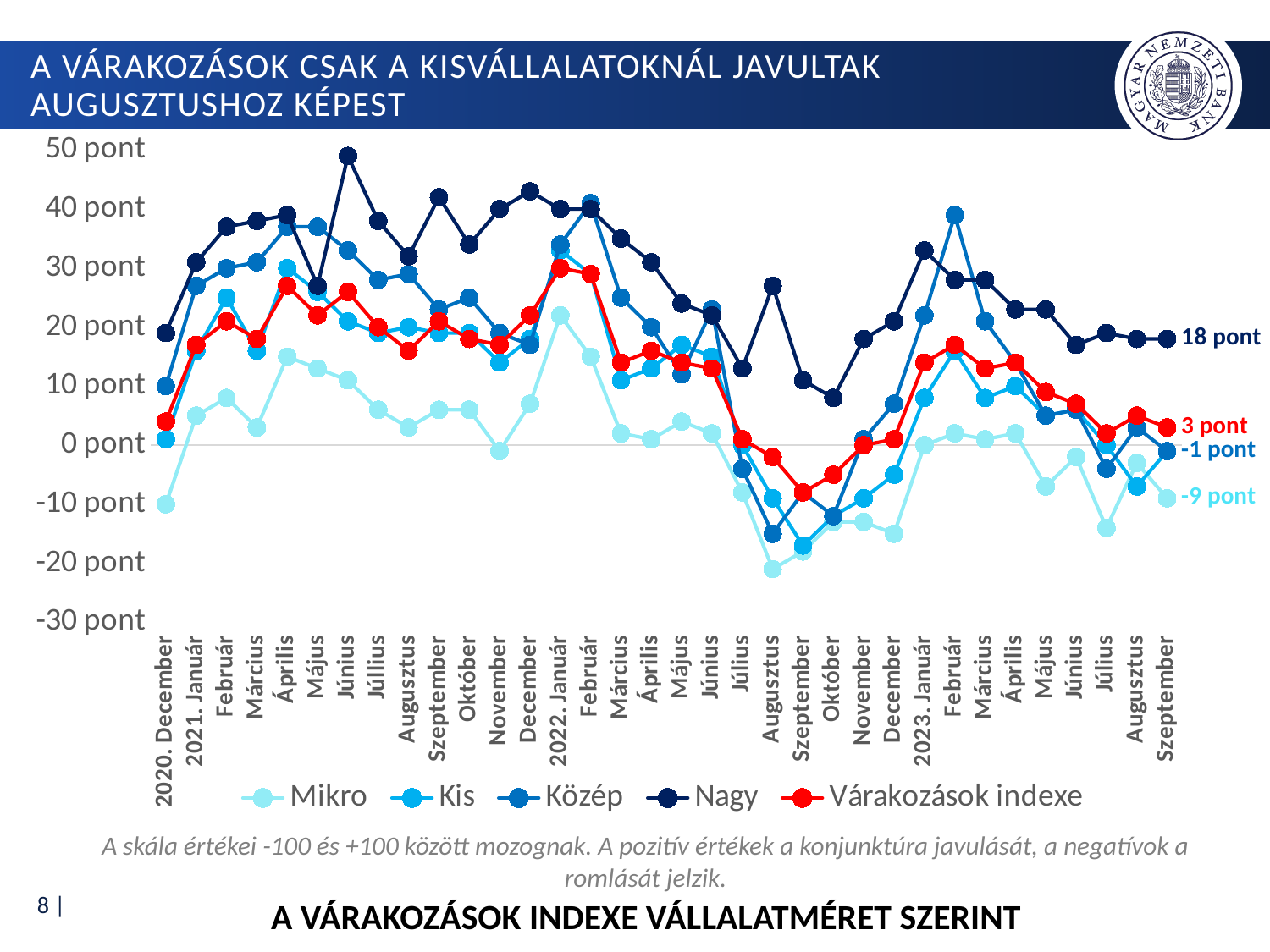
What kind of chart is shown on the slide? line chart Is the value for Mikro in 2022 Augusztus greater or less than -10 pont? less What is the value of the Nagy series in 2023 Szeptember? 18 pont Which series has the highest value in 2023 Szeptember? Nagy What is the value of the Mikro series in 2023 Szeptember? -9 pont Does the Nagy series rise or fall from 2023 Január to 2023 Szeptember? fall Is the value for Nagy in 2021 Június greater or less than 40 pont? greater How many series does the legend list? 5 What is the title shown below the chart? A VÁRAKOZÁSOK INDEXE VÁLLALATMÉRET SZERINT Which series has the lowest value in 2023 Szeptember? Mikro What is the value of the Várakozások indexe series in 2023 Szeptember? 3 pont What is the difference between the Nagy and Mikro values in 2023 Szeptember? 27 pont